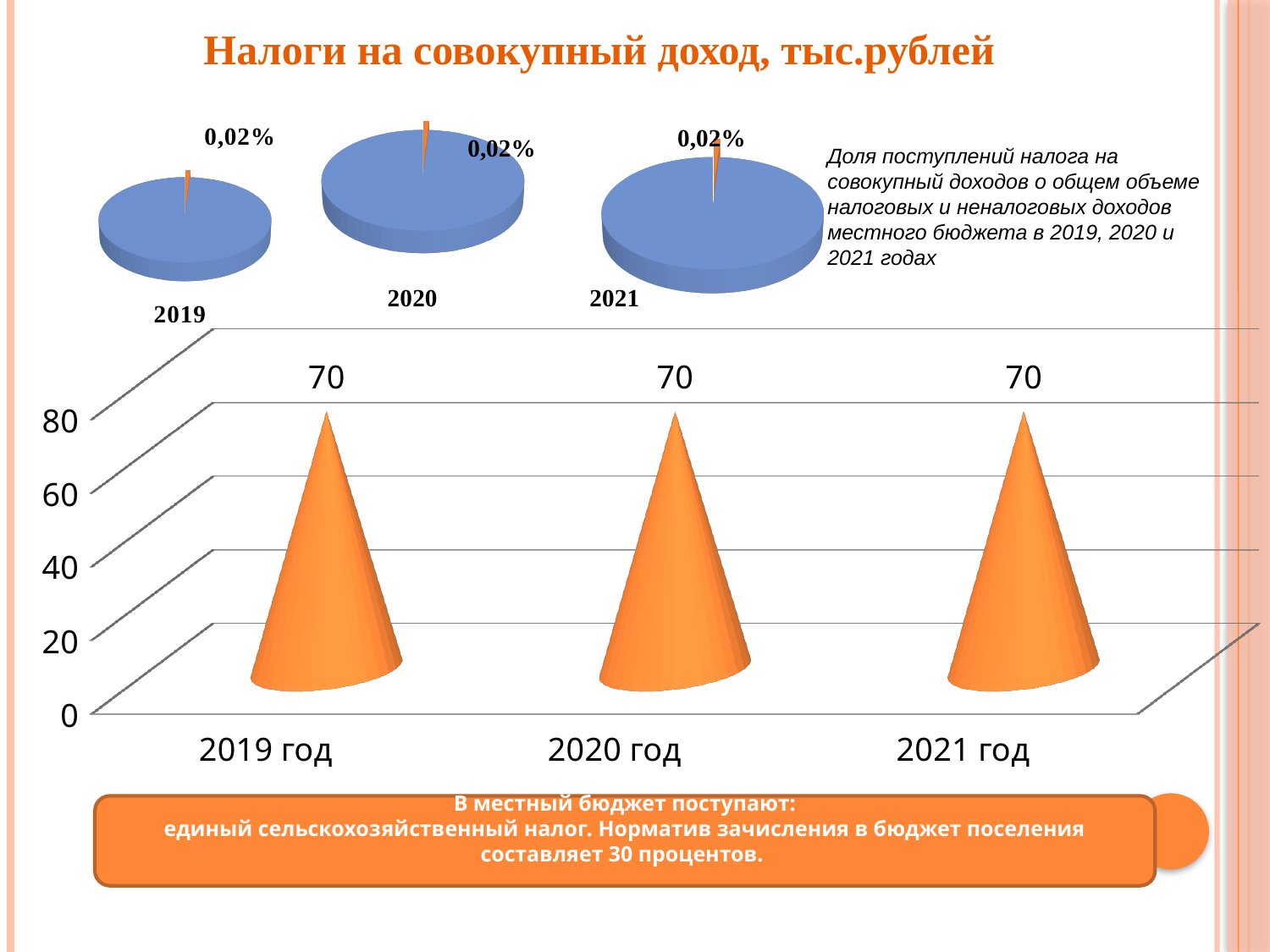
What kind of chart is the chart at the bottom of the slide? bar chart On the bar chart at the bottom of the slide, what is the value for 2019 год? 70 On the bar chart at the bottom of the slide, how many categories are shown on the x axis? 3 On the bar chart at the bottom of the slide, do the values rise, fall or stay the same from 2019 год to 2021 год? stay the same On the pie chart labelled 2021 at the top of the slide, what share is shown by the data label? 0,02% How many pie charts are shown at the top of the slide? 3 On the bar chart at the bottom of the slide, is the value for 2021 год greater or less than 80? less On the pie chart labelled 2019 at the top of the slide, what share is shown by the data label? 0,02% What is the title of the slide above the charts? Налоги на совокупный доход, тыс.рублей On the bar chart at the bottom of the slide, what is the difference between the values for 2020 год and 2019 год? 0 On the bar chart at the bottom of the slide, is the value for 2020 год greater or less than 60? greater On the bar chart at the bottom of the slide, what is the value for 2021 год? 70